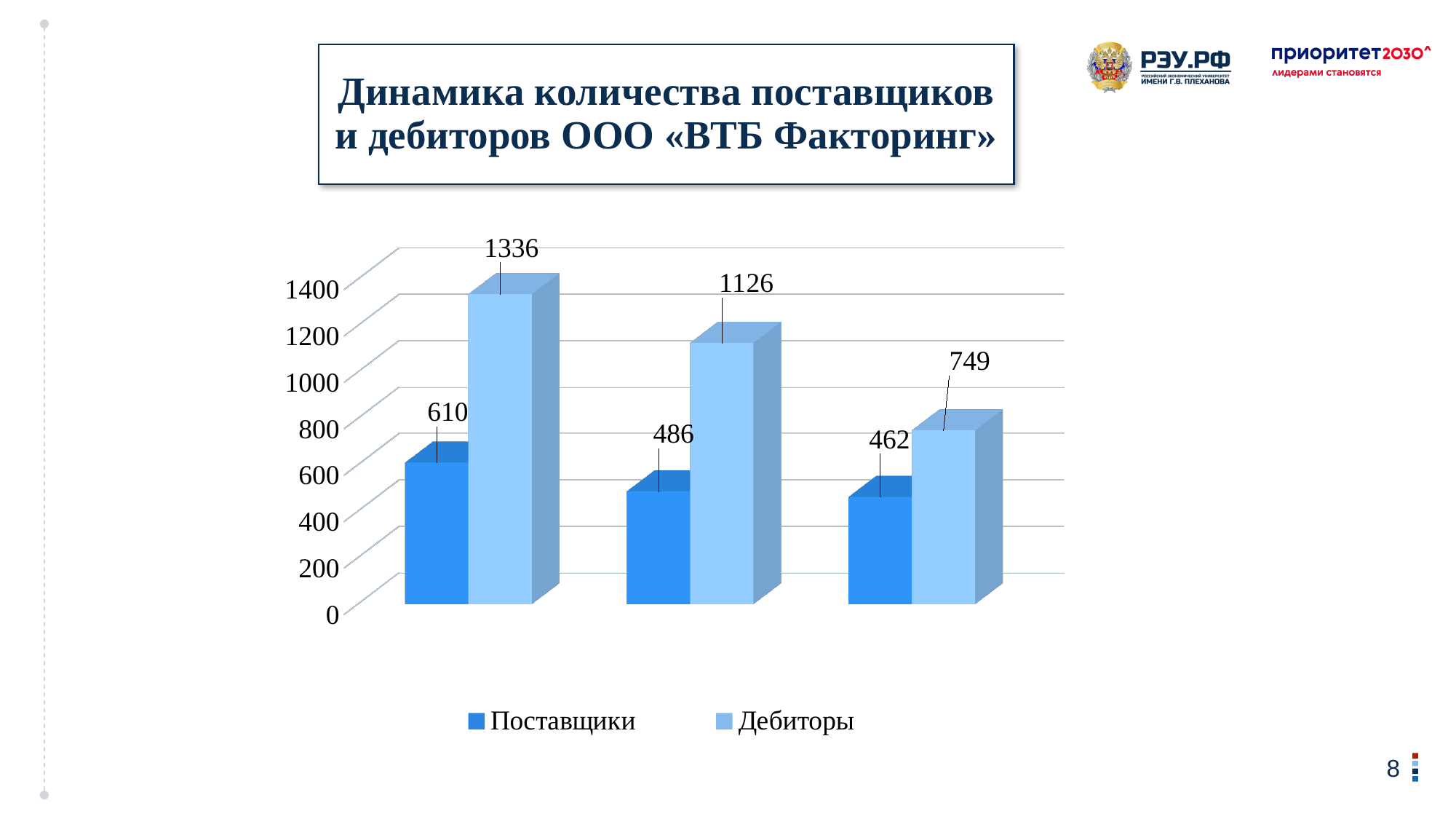
How many groups of bars are plotted in the chart? 3 What is the lowest value of Поставщики shown in the chart? 462 How many series does the legend list? 2 Do the Поставщики values rise or fall from left to right across the groups? fall What type of chart is shown on the slide? bar chart What is the value of Поставщики in the first (leftmost) group of bars? 610 What is the value of Дебиторы in the third (rightmost) group of bars? 749 What is the difference between Дебиторы and Поставщики in the first (leftmost) group of bars? 726 What is the value of Дебиторы in the second (middle) group of bars? 1126 In the third (rightmost) group of bars, which series has the larger value, Поставщики or Дебиторы? Дебиторы Which series is shown in the lighter blue colour in the legend? Дебиторы What is the highest value of Дебиторы shown in the chart? 1336